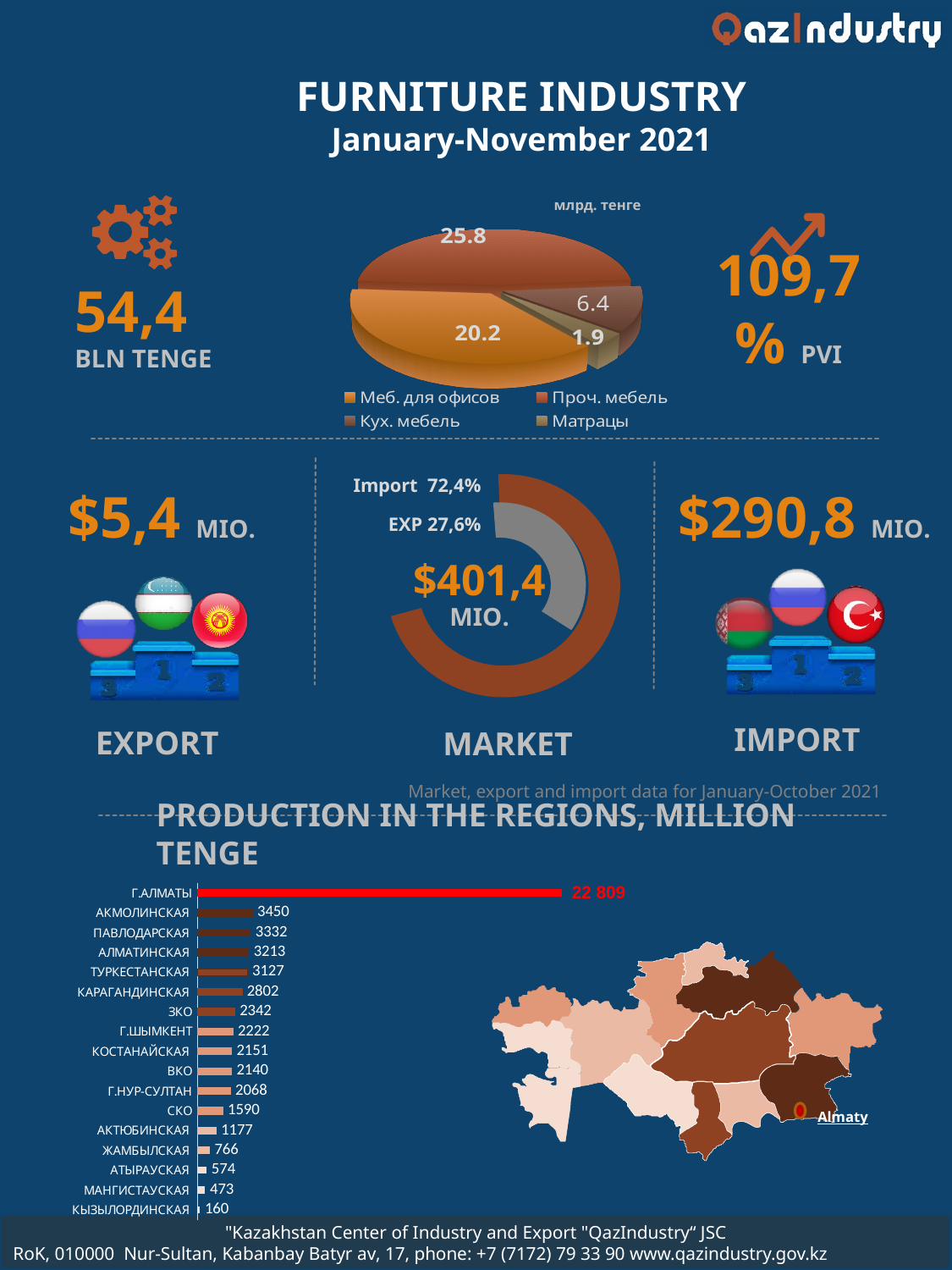
In the MARKET donut chart, what share is shown for Import? 72,4% In the bar chart 'Production in the regions, million tenge', which region has the highest value? Г.АЛМАТЫ In the bar chart 'Production in the regions, million tenge', which is larger, ЗКО or ВКО? ЗКО How many entries does the legend of the pie chart labelled 'млрд. тенге' list? 4 In the bar chart 'Production in the regions, million tenge', what is the value for Г.АЛМАТЫ? 22 809 In the pie chart labelled 'млрд. тенге', what is the value of the largest slice? 25.8 In the bar chart 'Production in the regions, million tenge', what is the difference between АКМОЛИНСКАЯ and АТЫРАУСКАЯ? 2876 In the pie chart labelled 'млрд. тенге', what is the value for Матрацы? 1.9 In the bar chart 'Production in the regions, million tenge', what is the value for ПАВЛОДАРСКАЯ? 3332 In the bar chart 'Production in the regions, million tenge', which region has the lowest value? КЫЗЫЛОРДИНСКАЯ What kind of chart is used for 'Production in the regions, million tenge'? Bar chart How many regions are listed in the bar chart 'Production in the regions, million tenge'? 17